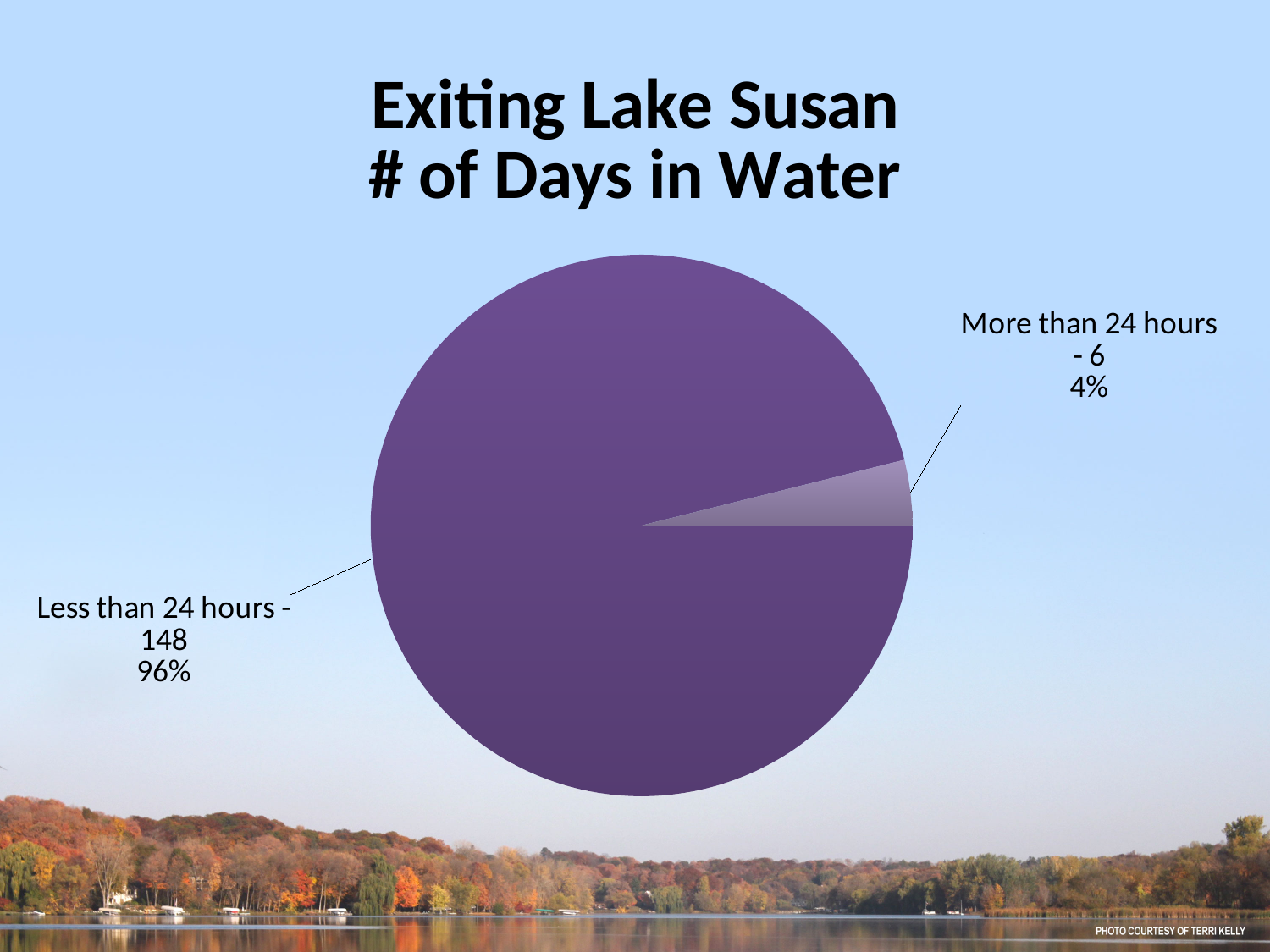
Which category has the largest slice? Less than 24 hours How many slices does the pie chart have? 2 Which is larger, the value for 'Less than 24 hours' or 'More than 24 hours'? Less than 24 hours What percentage share does 'Less than 24 hours' have? 96% What percentage share does 'More than 24 hours' have? 4% What is the total of the two slice values? 154 What kind of chart is shown on the slide? pie chart Which category has the smallest slice? More than 24 hours What is the value for 'More than 24 hours'? 6 What is the difference between the values for 'Less than 24 hours' and 'More than 24 hours'? 142 What is the title of the chart? Exiting Lake Susan # of Days in Water What is the value for 'Less than 24 hours'? 148